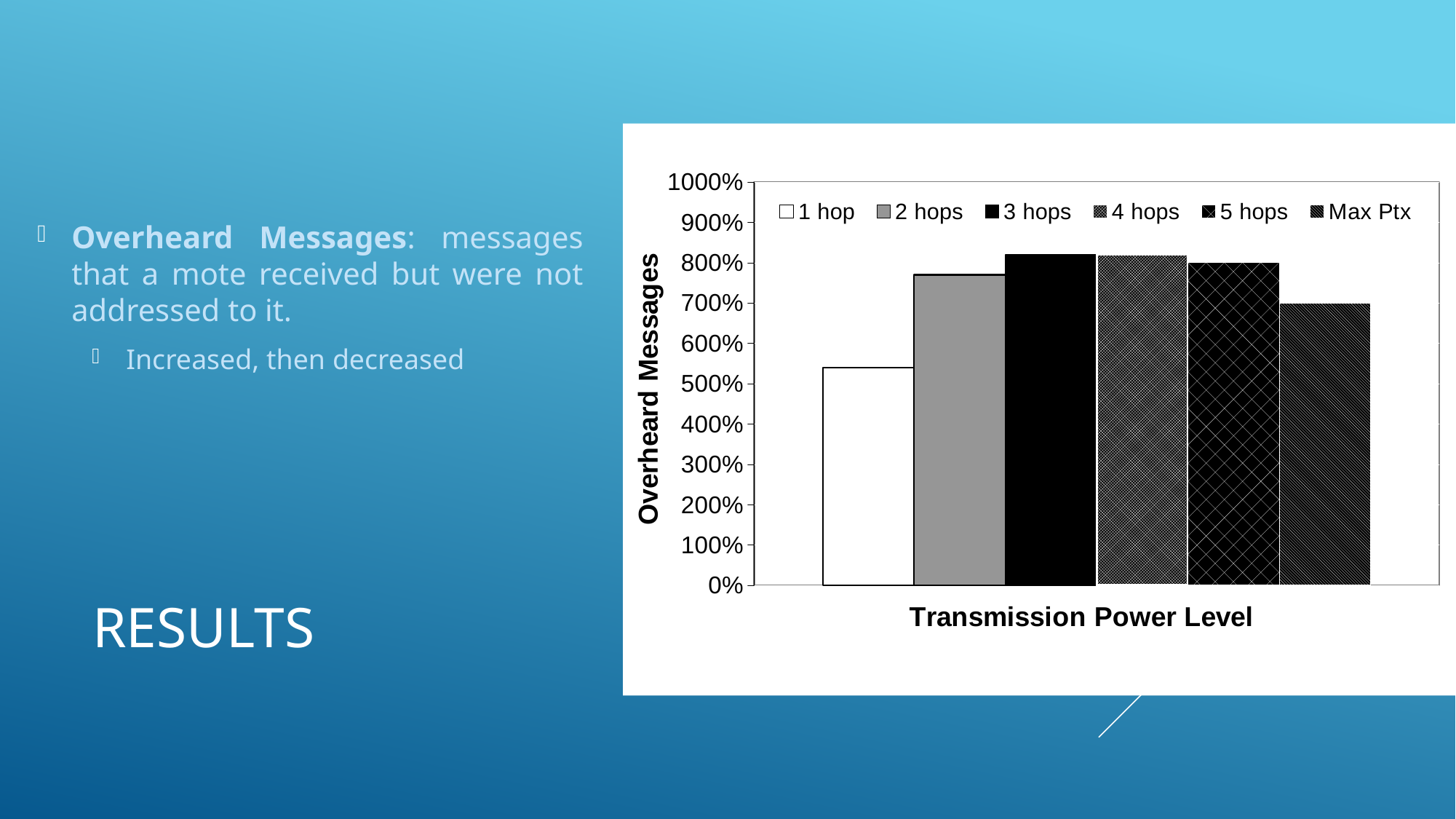
Is the value for 1 hop greater or less than 500%? greater Is the value for 4 hops greater or less than 700%? greater Is the value for 2 hops greater or less than 800%? less Which series has the lowest value for Overheard Messages? 1 hop Do the bar values rise or fall from 1 hop through to Max Ptx? rise, then fall What kind of chart is shown on the slide? bar chart How many series does the legend list? 6 Which is larger, the value for 1 hop or the value for 2 hops? 2 hops What is the title of the vertical axis? Overheard Messages Which is larger, the value for 5 hops or the value for Max Ptx? 5 hops